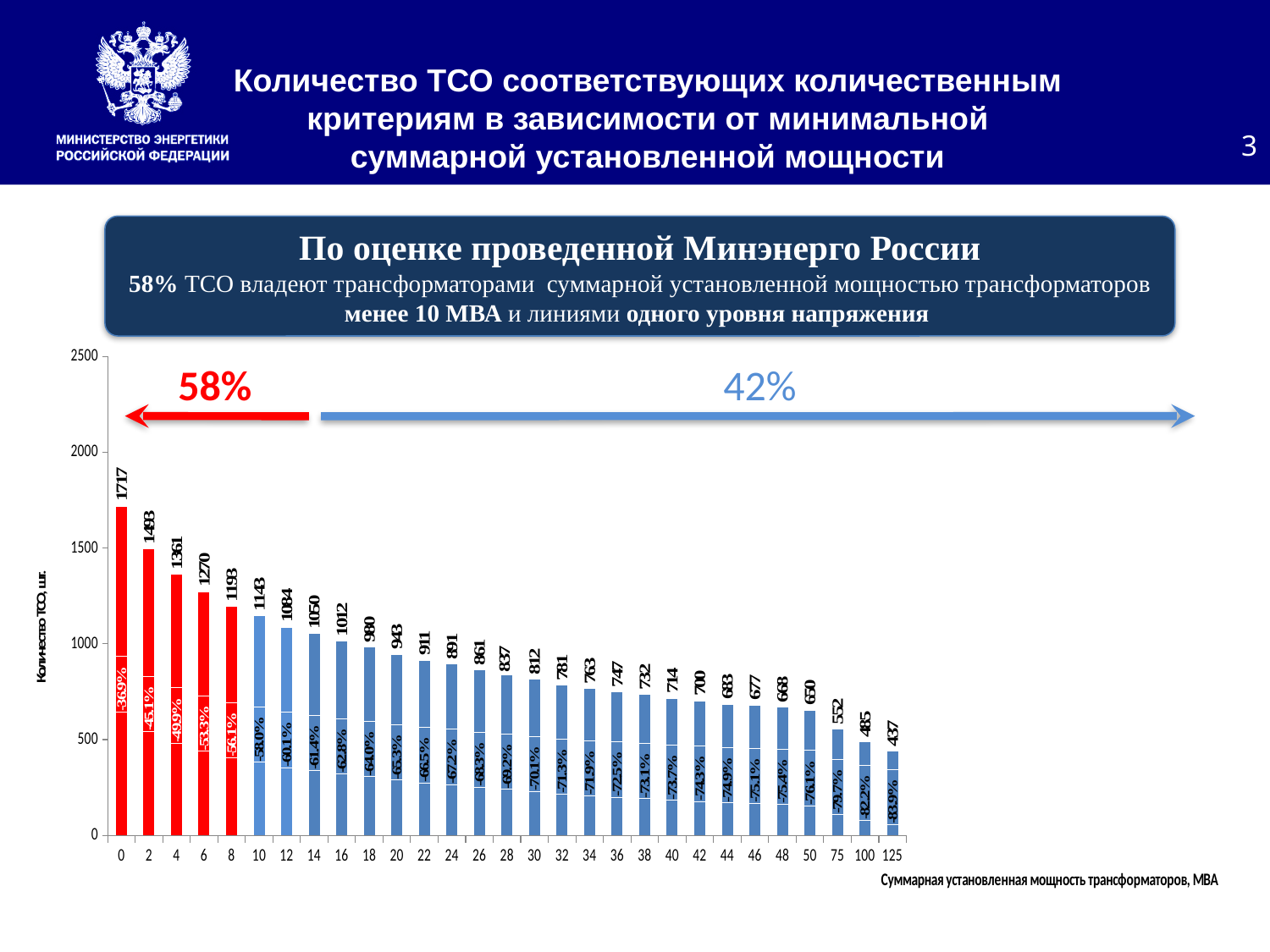
Which has a larger value, category 20 or category 30? 20 What is the value for the category 125 on the x axis? 437 Do the values rise or fall as you move from left to right along the x axis? fall How many categories are shown on the x axis? 29 What is the difference between the values for categories 0 and 2? 224 Which x-axis category has the highest value? 0 What is the value for the category 50 on the x axis? 650 What kind of chart is shown on the slide? bar chart What is the value for the category 10 on the x axis? 1143 Which x-axis category has the lowest value? 125 What is the value for the category 0 on the x axis? 1717 Is the value for category 100 greater or less than 500? less